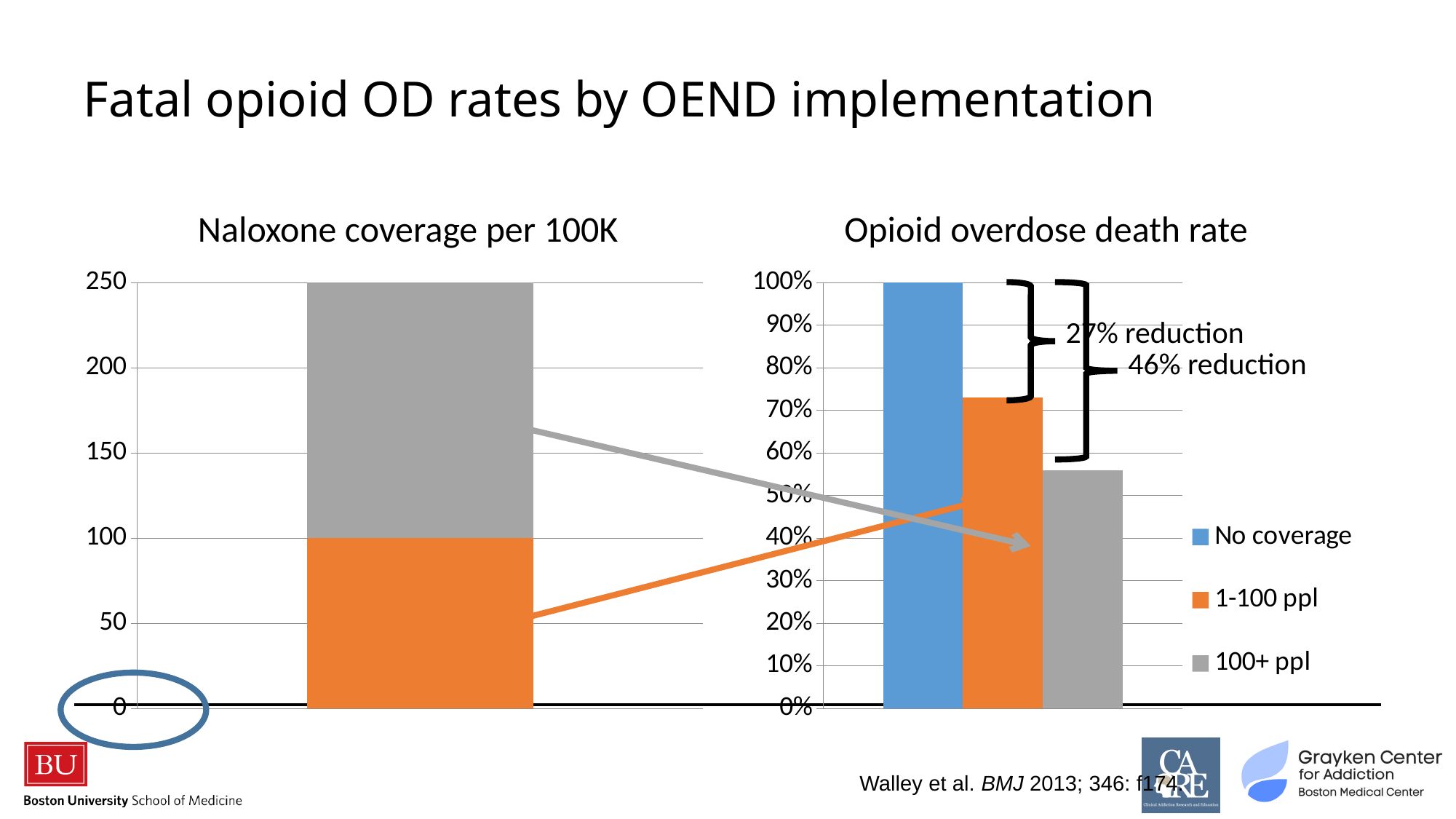
In the 'Opioid overdose death rate' chart, is the value for 1-100 ppl greater or less than 80%? less What kind of chart is the 'Opioid overdose death rate' chart? bar chart In the 'Opioid overdose death rate' chart, which is larger, the bar for 1-100 ppl or the bar for 100+ ppl? 1-100 ppl In the 'Opioid overdose death rate' chart, which category has the highest bar? No coverage In the 'Opioid overdose death rate' chart, which category has the lowest bar? 100+ ppl In the 'Opioid overdose death rate' chart, what is the value for No coverage? 100% How many series does the legend list? 3 What kind of chart is the 'Naloxone coverage per 100K' chart? bar chart In the 'Naloxone coverage per 100K' chart, what is the total height of the stacked bar? 250 In the 'Opioid overdose death rate' chart, is the value for 100+ ppl greater or less than 60%? less In the 'Opioid overdose death rate' chart, do the bars rise or fall from left to right? fall In the 'Opioid overdose death rate' chart, what reduction is annotated for the 100+ ppl bar? 46% reduction